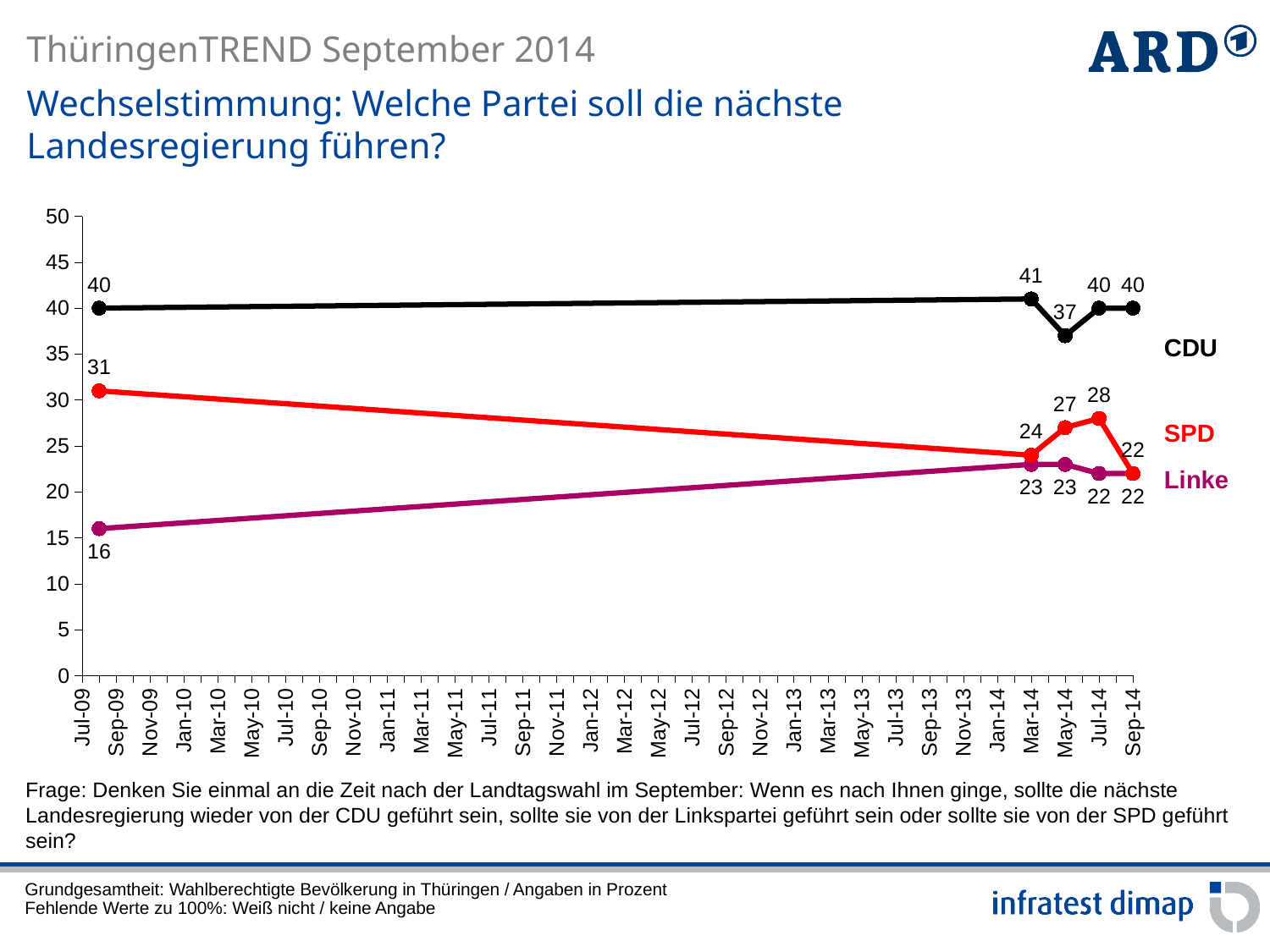
What colour is the SPD line? Red Which party has the highest value in Sep-14? CDU What value does the CDU line show for May-14? 37 What value does the CDU line show for Jul-09? 40 What value does the Linke line show for Sep-14? 22 Does the Linke line rise or fall from Jul-09 to Mar-14? Rise Which is larger in Jul-14, the SPD value or the Linke value? SPD What kind of chart is shown on the slide? Line chart What value does the SPD line show for Jul-14? 28 How many series does the chart show? 3 What is the difference between the CDU and SPD values in Sep-14? 18 Which party has the lowest value in Jul-09? Linke